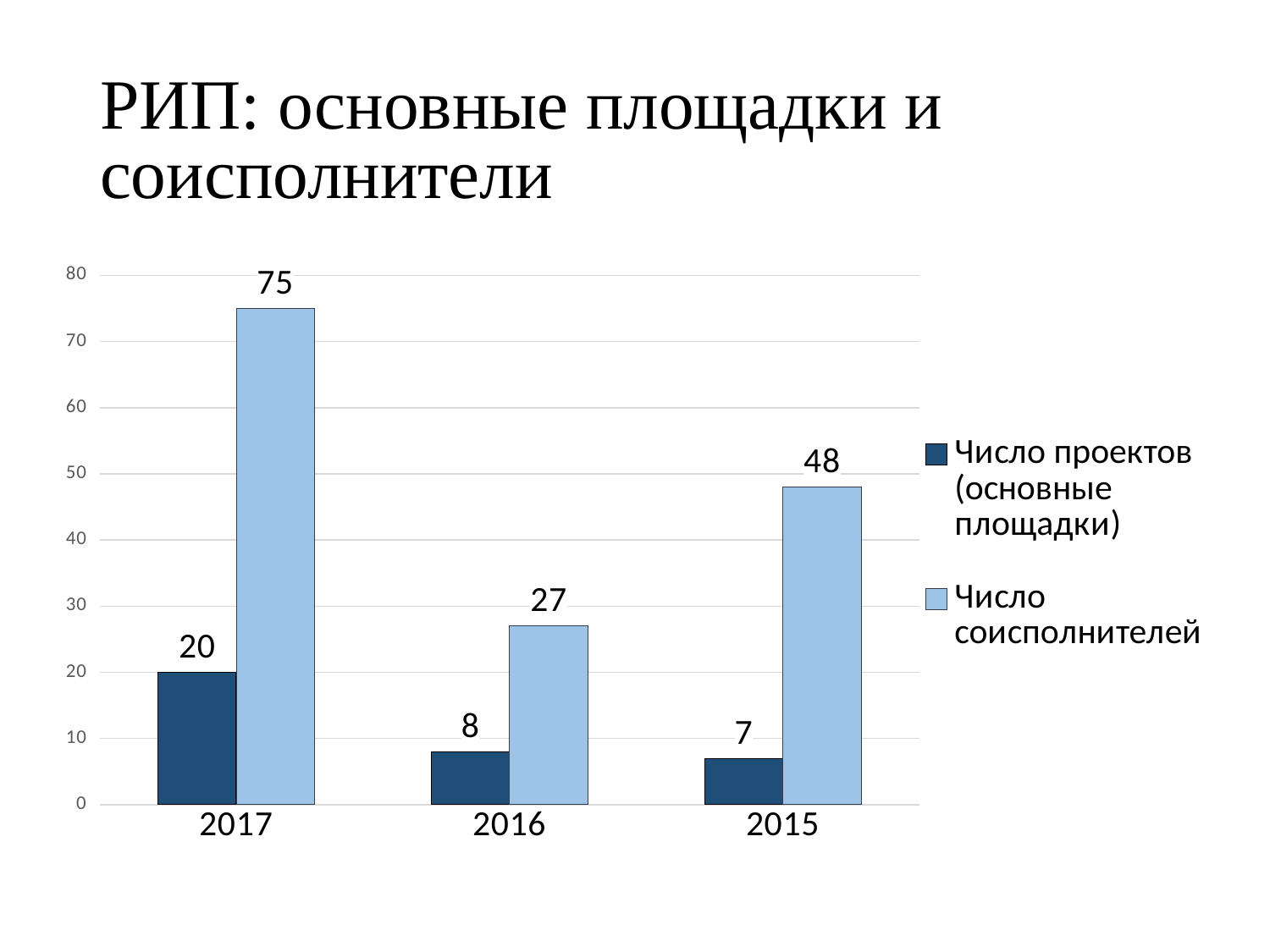
What is the difference between Число соисполнителей and Число проектов (основные площадки) in 2017? 55 Which year has the highest value for Число соисполнителей? 2017 What is the value of Число соисполнителей for 2017? 75 How many series does the legend list? 2 What is the value of Число соисполнителей for 2015? 48 What kind of chart is shown on the slide? bar chart What is the value of Число проектов (основные площадки) for 2016? 8 Which year has the lowest value for Число проектов (основные площадки)? 2015 How many years are shown on the x axis? 3 What is the difference in Число соисполнителей between 2015 and 2016? 21 Is the value of Число соисполнителей for 2016 greater or less than 30? less Which is larger: Число проектов (основные площадки) in 2017 or in 2016? 2017